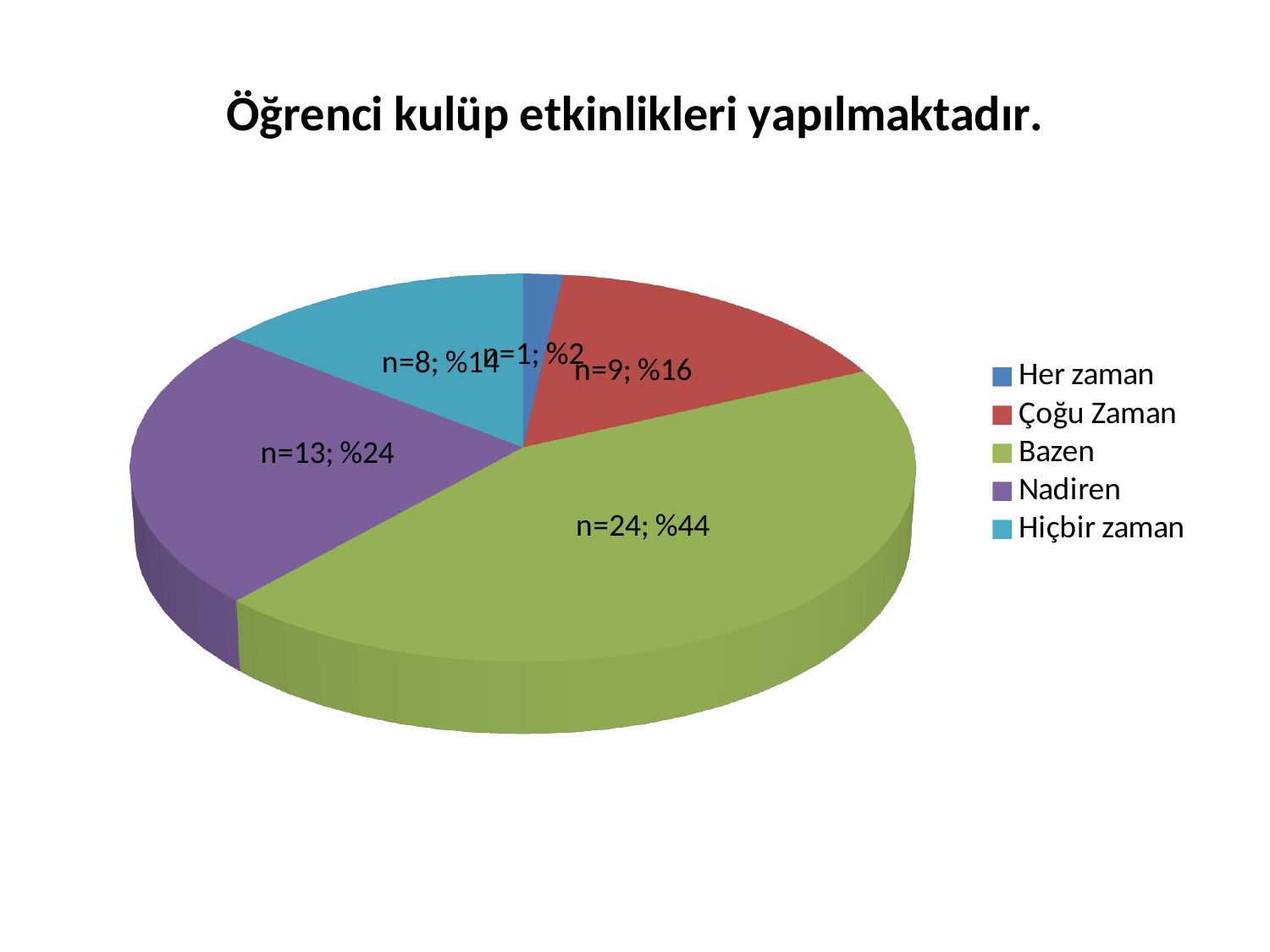
Which category has the largest slice of the pie? Bazen What is the data label for the Her zaman slice? n=1; %2 What colour is the Bazen slice in the legend? Green What kind of chart is shown on the slide? Pie chart Which slice is larger, Nadiren or Çoğu Zaman? Nadiren What is the data label for the Çoğu Zaman slice? n=9; %16 What is the n value for the Hiçbir zaman slice? n=8 What is the difference in n between the Bazen and Nadiren slices? 11 Which category has the smallest slice of the pie? Her zaman What is the data label for the Nadiren slice? n=13; %24 How many categories does the pie chart have? 5 What is the data label for the Bazen slice? n=24; %44